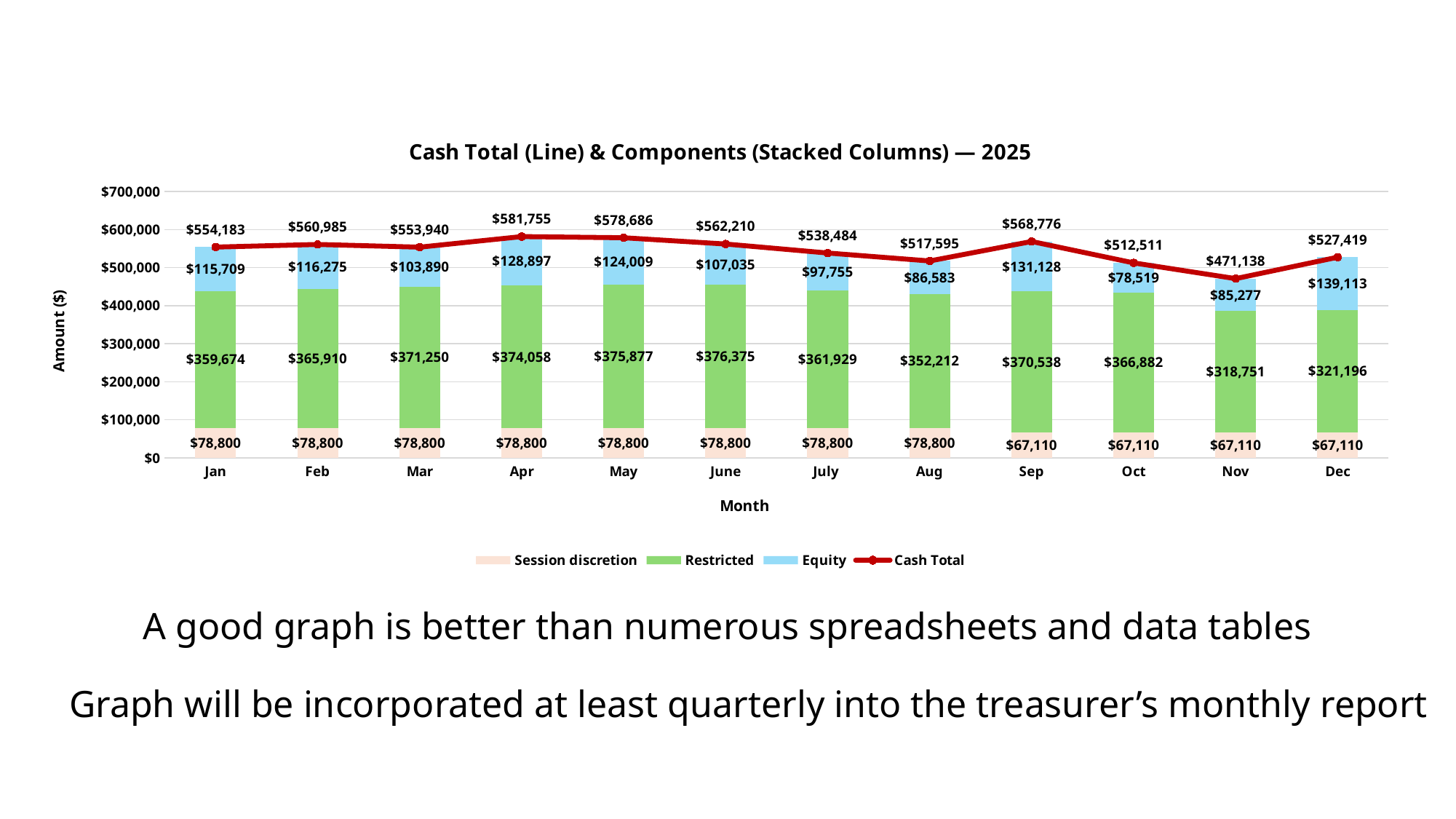
What is the difference between the Equity values for December and November? $53,836 Which is larger, the Restricted value for June or for November? June Which month has the lowest Cash Total? Nov How many series does the legend list? 4 What is the Cash Total for April? $581,755 Which month has the highest Cash Total? Apr What is the Session discretion value for November? $67,110 What is the Equity value for September? $131,128 How many months are shown on the x axis? 12 What is the total of the stacked bar for January? $554,183 What kind of chart is this? Combination stacked bar and line chart Which month has the highest Equity value? Dec